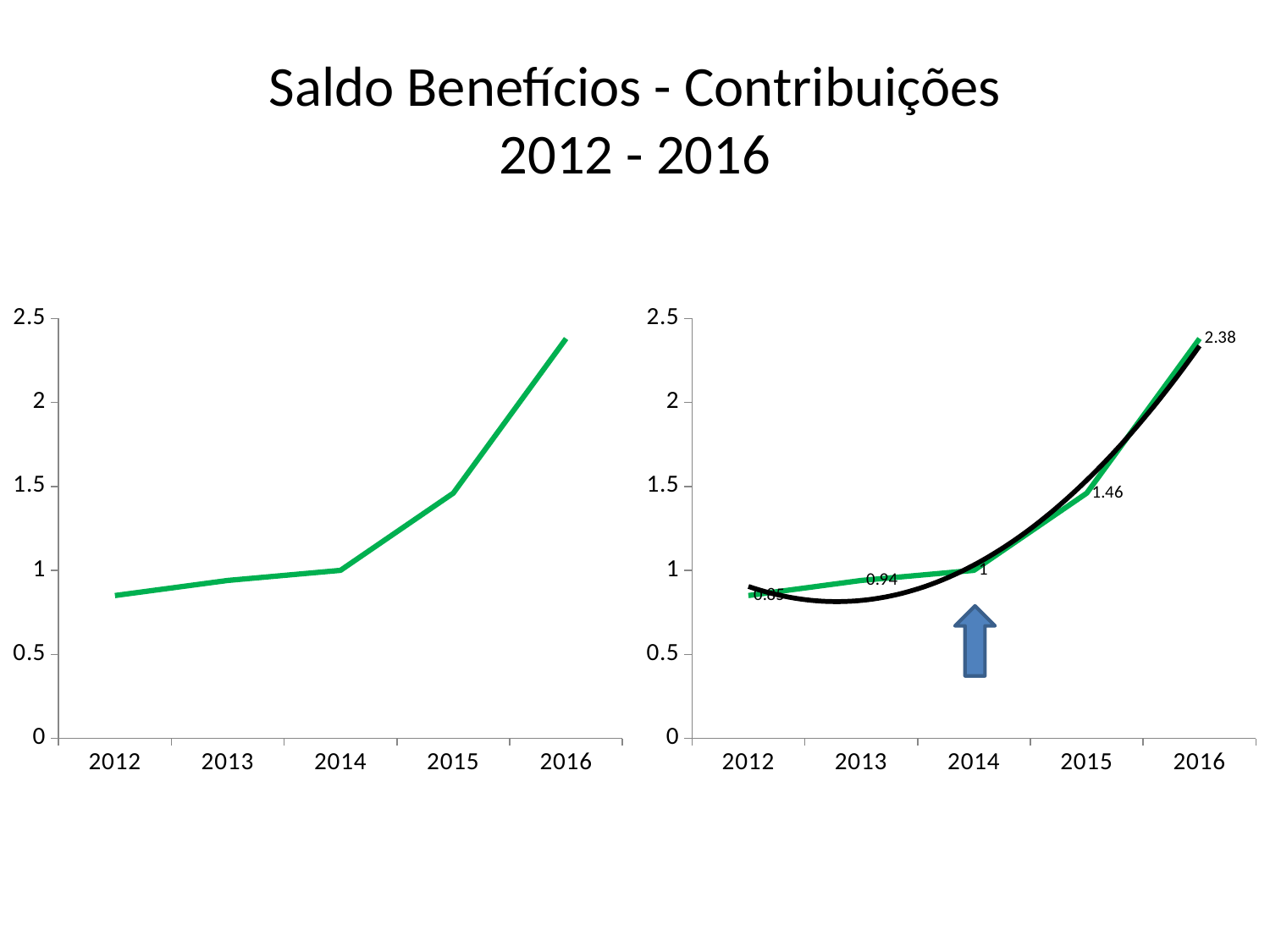
On the right chart, what is the value for 2015? 1.46 On the right chart, which year has the highest value? 2016 On the right chart, what is the difference between the values for 2016 and 2015? 0.92 How many years are plotted on the left chart? 5 On the left chart, do the values rise or fall from 2012 to 2016? rise On the left chart, is the value for 2016 greater or less than 2? greater On the right chart, which is larger, the value for 2013 or the value for 2014? 2014 On the right chart, what is the difference between the values for 2015 and 2014? 0.46 On the right chart, what is the value for 2014? 1 On the right chart, what is the value for 2016? 2.38 On the right chart, what is the value for 2013? 0.94 What kind of chart is the left chart? line chart